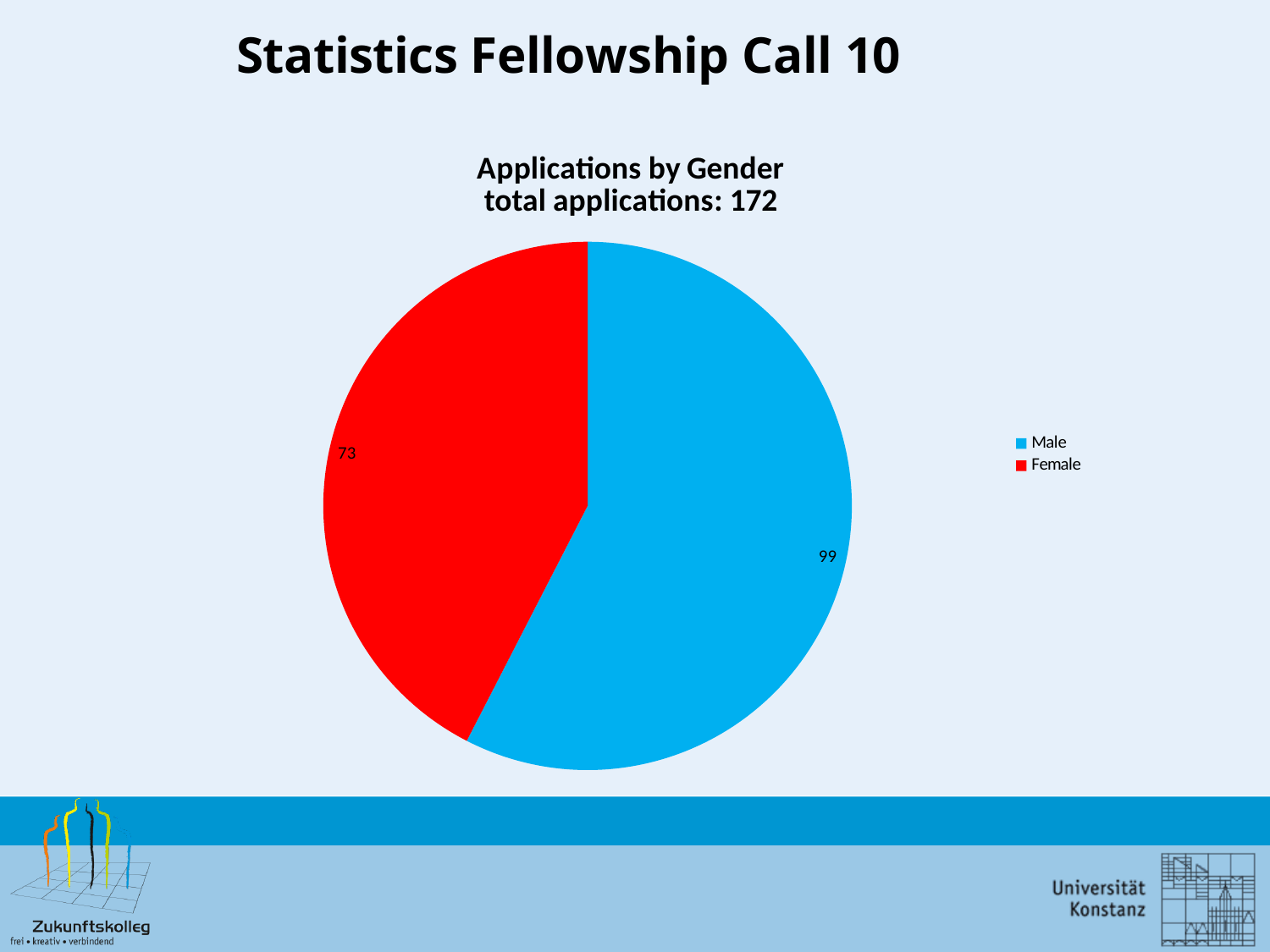
What is the number of applications from Male applicants? 99 Is the value for Female larger or smaller than the value for Male? smaller Which gender has the smaller number of applications? Female What share of the total applications (172) is the Male slice, to one decimal place? 57.6% What colour is the Female slice of the pie chart? red What kind of chart is shown on the slide? pie chart How many more applications came from Male applicants than from Female applicants? 26 How many entries does the legend list? 2 Which gender has the larger number of applications? Male What is the total number of applications shown in the chart title? 172 How many slices does the pie chart have? 2 What is the number of applications from Female applicants? 73